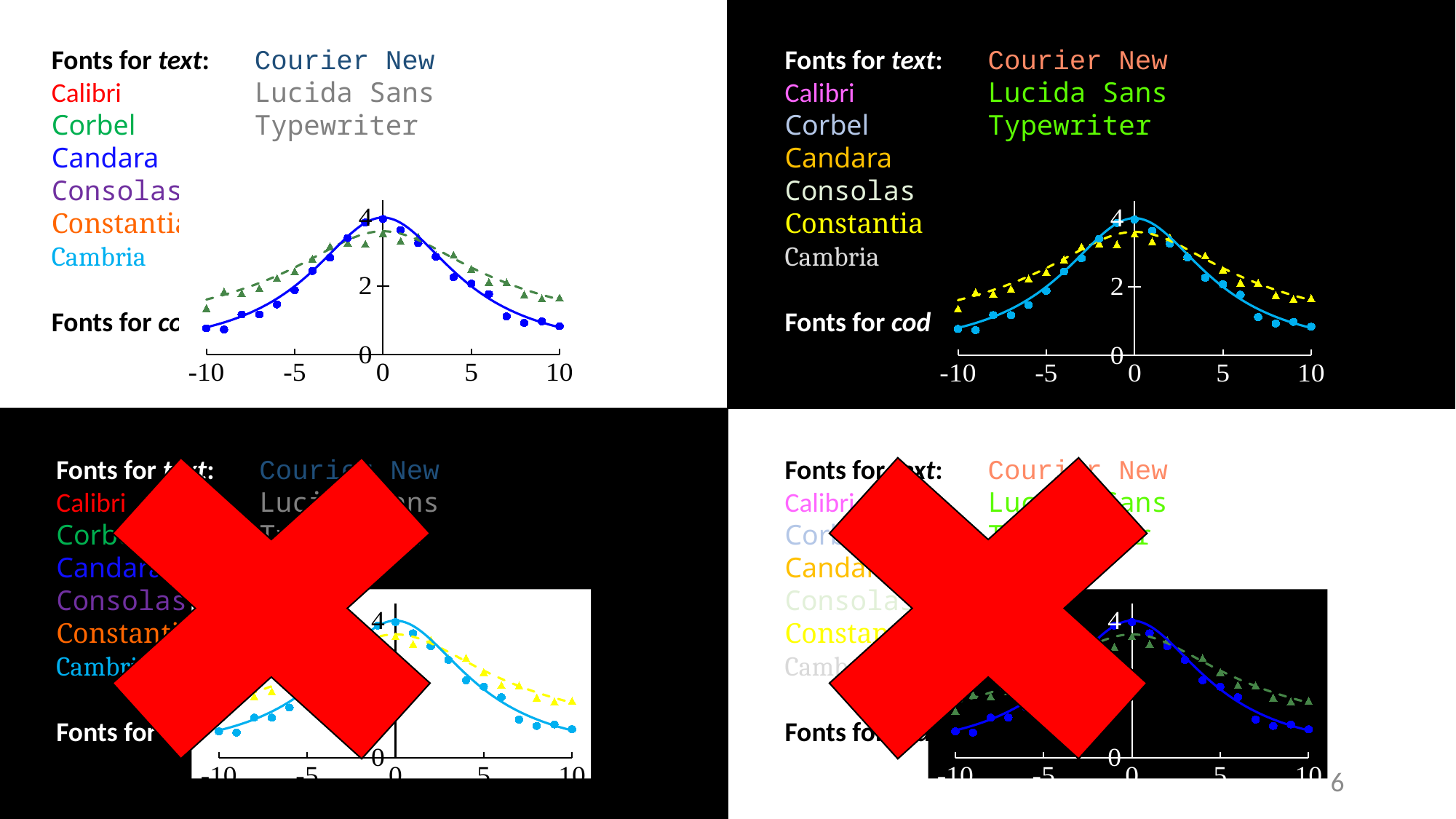
In the top-left chart, at x = 0, which series is higher: the solid line with circles or the dashed line with triangles? the solid line with circles In the top-left chart, do the values of the solid blue line rise or fall as x goes from 0 to 10? fall In the top-left chart, at which x value does the solid blue line reach its highest point? 0 In the top-left chart, is the peak value of the solid blue line greater or less than 2? greater In the top-right chart, what is the highest tick label shown on the y axis? 4 In the top-left chart, how many data series are plotted? 4 In the top-left chart, is the value of the solid blue line at x = 10 greater or less than 2? less In the top-left chart, do the values of the solid blue line rise or fall as x goes from -10 to 0? rise In the top-left chart, at x = -10, which series is higher: the solid line with circles or the dashed line with triangles? the dashed line with triangles In the top-left chart, what kind of chart is shown? line chart In the top-right chart, is the value of the dashed yellow line at x = 10 greater or less than 2? less In the top-right chart, what range does the x axis cover? -10 to 10